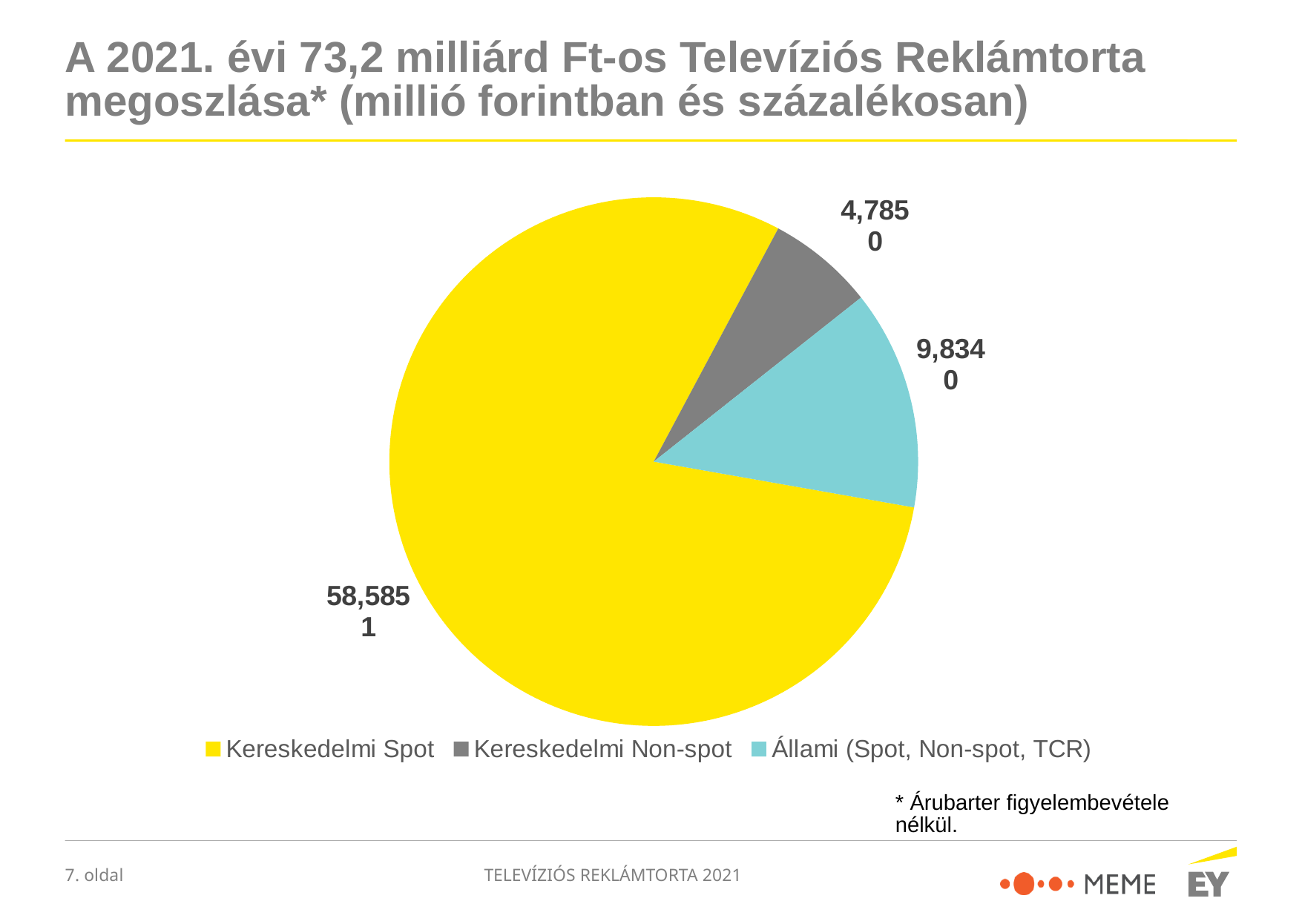
Which is larger, Állami (Spot, Non-spot, TCR) or Kereskedelmi Non-spot? Állami (Spot, Non-spot, TCR) How many slices does the pie chart have? 3 What is the value for Kereskedelmi Non-spot? 4,785 Which category has the smallest slice of the pie? Kereskedelmi Non-spot What is the value for Állami (Spot, Non-spot, TCR)? 9,834 How many entries does the legend list? 3 Which category has the largest slice of the pie? Kereskedelmi Spot What is the difference between the values for Állami (Spot, Non-spot, TCR) and Kereskedelmi Non-spot? 5,049 What is the difference between the values for Kereskedelmi Spot and Kereskedelmi Non-spot? 53,800 What is the value for Kereskedelmi Spot? 58,585 What kind of chart is shown on the slide? Pie chart What colour is the Kereskedelmi Spot slice? Yellow